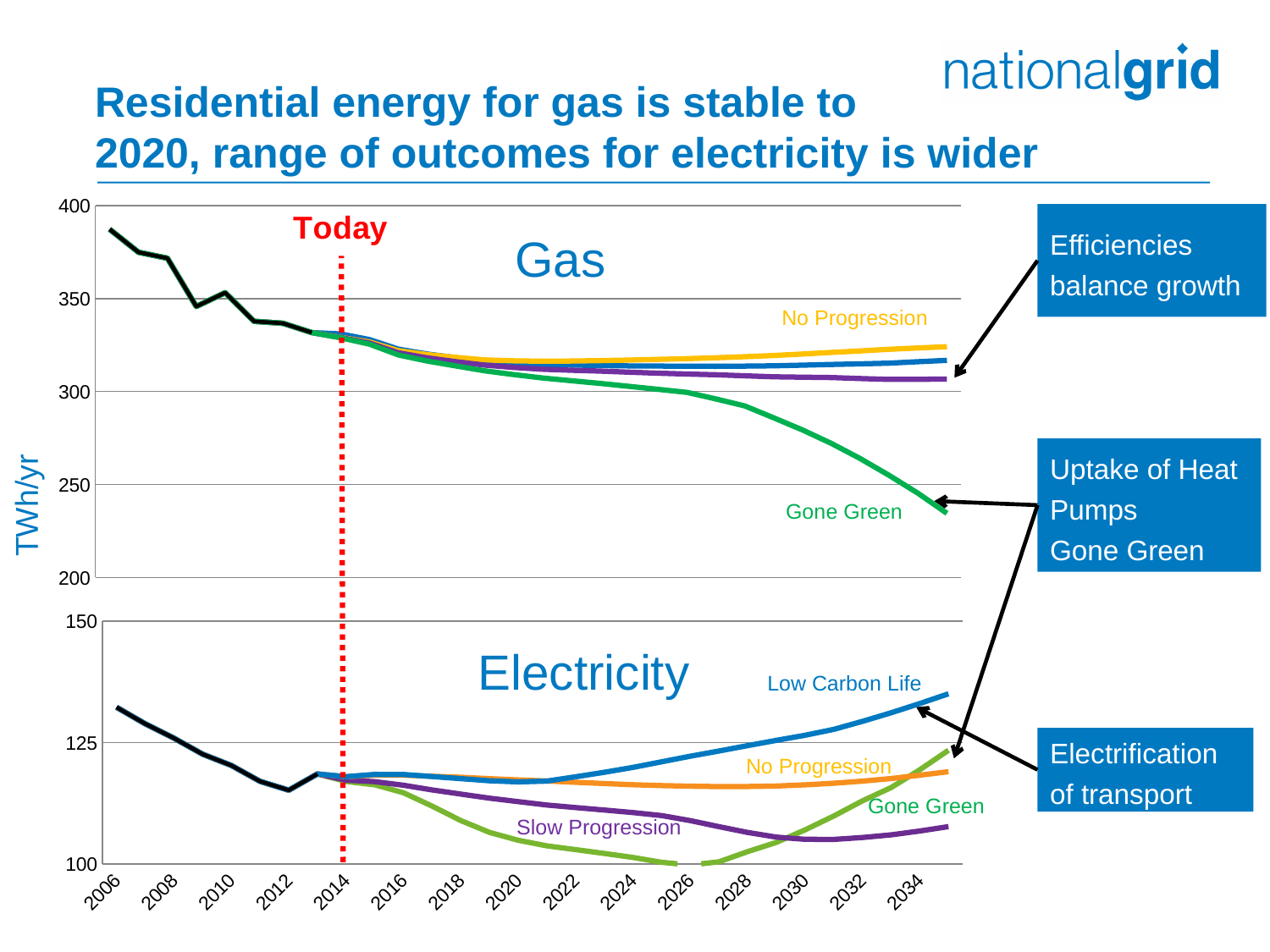
On the Gas chart, is the value in 2006 greater or less than 350? greater On the Gas chart, is the value for the No Progression scenario in 2034 greater or less than 300? greater On the Gas chart, which scenario has the larger value in 2034, No Progression or Gone Green? No Progression On the Electricity chart, which scenario has the larger value in 2034, Low Carbon Life or Slow Progression? Low Carbon Life On the Gas chart, is the value for the Gone Green scenario in 2034 greater or less than 250? less On the Electricity chart, does the Low Carbon Life line rise or fall between 2020 and 2034? rise What kind of chart is the Gas chart at the top of the slide? line chart How many scenario labels are shown on the Electricity chart? 4 What unit is shown on the y axis of the charts? TWh/yr On the Gas chart, does the Gone Green line rise or fall between 2014 and 2034? fall